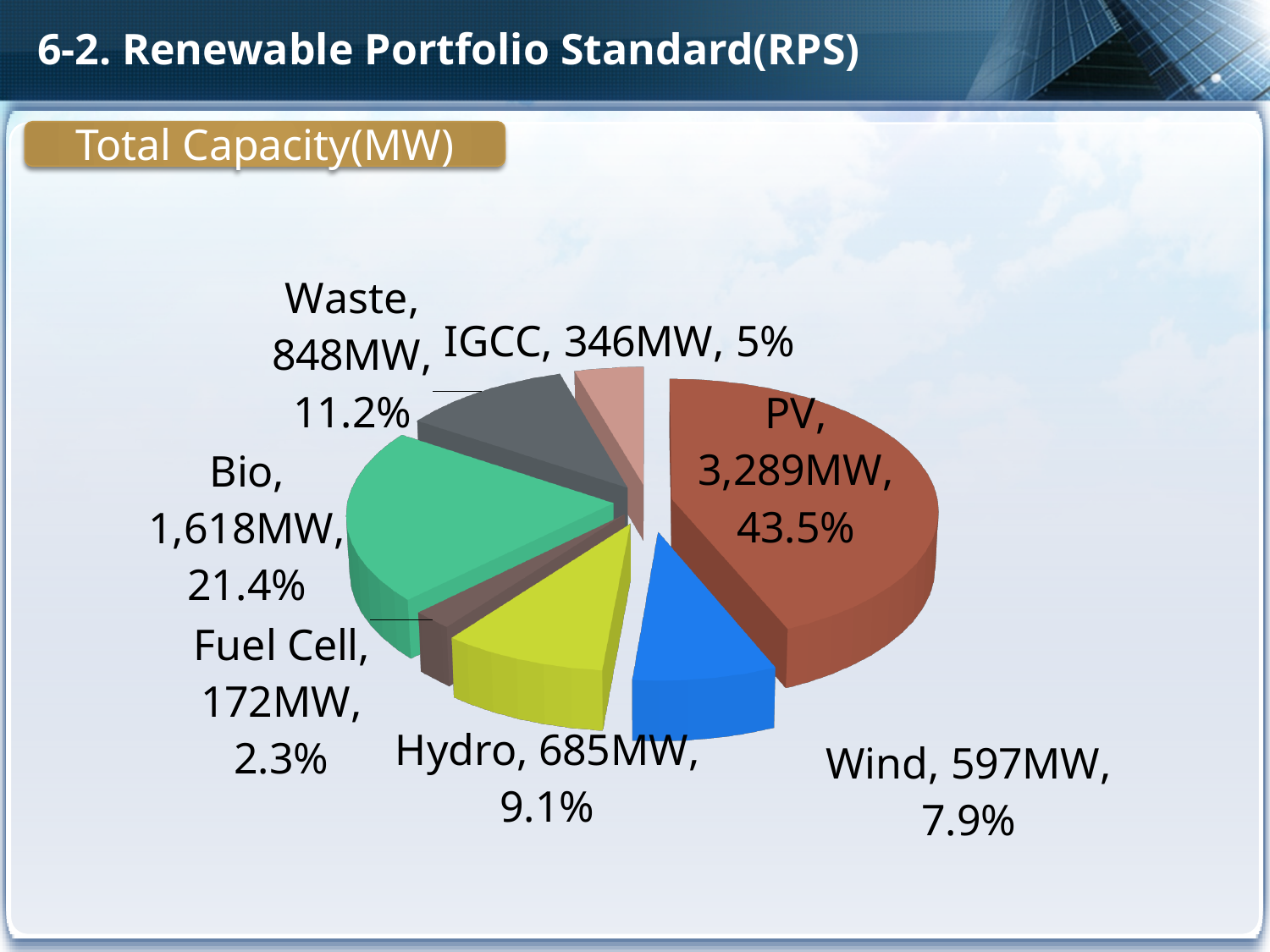
Which category has the smallest slice of the pie? Fuel Cell What percentage is shown for IGCC? 5% Which has a larger capacity, Bio or Waste? Bio What is the capacity shown for Waste? 848MW What kind of chart is shown on the slide? pie chart How many slices does the pie chart have? 7 What is the title shown above the pie chart? Total Capacity(MW) Which category has the largest slice of the pie? PV What is the capacity shown for Fuel Cell? 172MW What is the difference in capacity between Hydro and Wind? 88MW What is the capacity shown for PV? 3,289MW What share of the pie does Bio account for? 21.4%